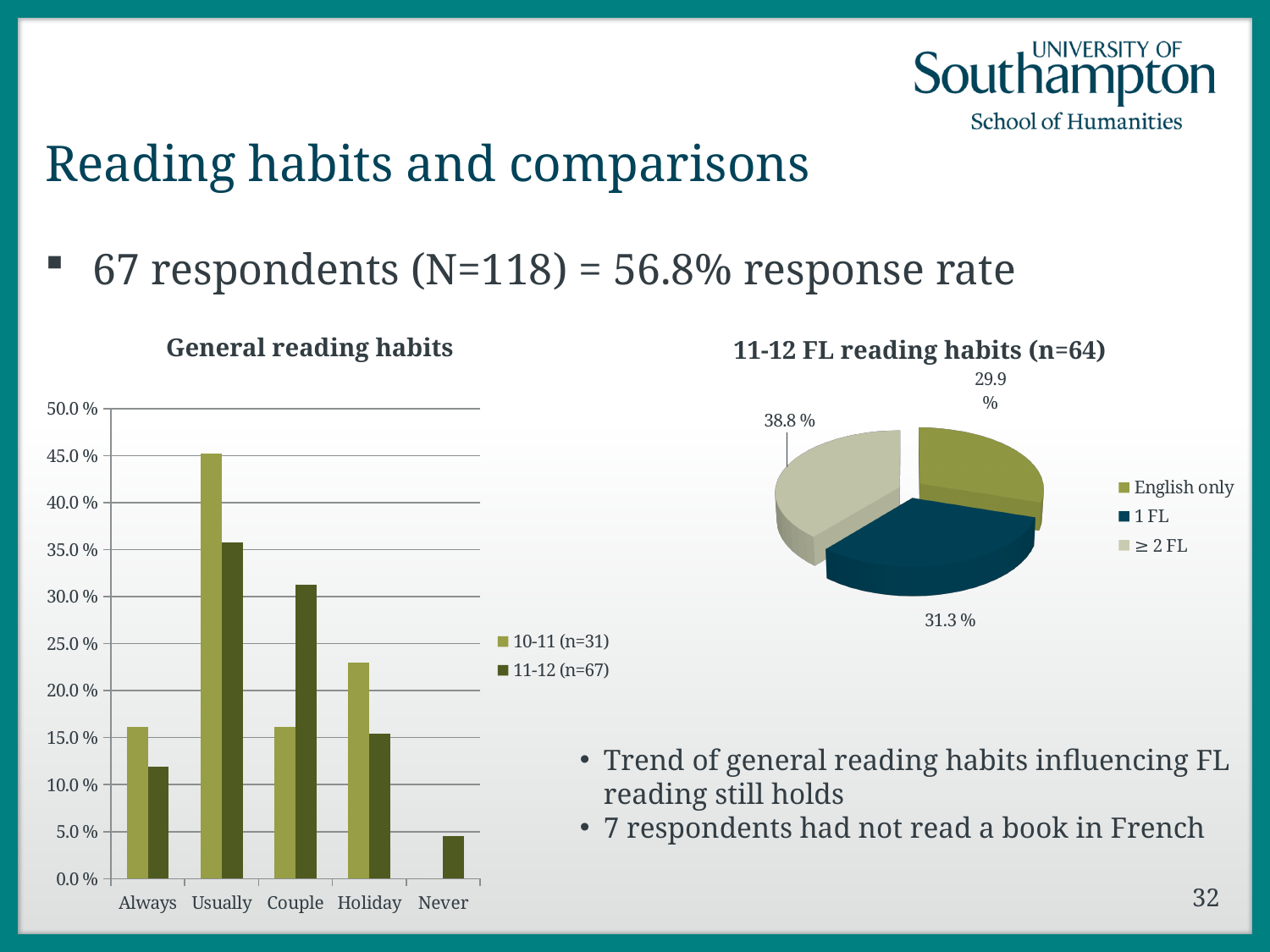
What kind of chart is the '11-12 FL reading habits (n=64)' chart? pie chart In the '11-12 FL reading habits (n=64)' chart, what share is labelled for the 'English only' slice? 29.9 % How many series does the legend of the 'General reading habits' chart list? 2 What kind of chart is the 'General reading habits' chart? bar chart In the '11-12 FL reading habits (n=64)' chart, what share is labelled for the '1 FL' slice? 31.3 % In the 'General reading habits' chart, for the 'Couple' category, which series has the larger value? 11-12 (n=67) In the 'General reading habits' chart, is the value for 'Usually' in the '10-11 (n=31)' series greater or less than 40.0 %? greater In the '11-12 FL reading habits (n=64)' chart, what share is labelled for the '≥ 2 FL' slice? 38.8 % In the 'General reading habits' chart, which category has the highest value for the '10-11 (n=31)' series? Usually In the '11-12 FL reading habits (n=64)' chart, what is the difference between the '≥ 2 FL' share and the 'English only' share? 8.9 % In the '11-12 FL reading habits (n=64)' chart, which slice is the largest? ≥ 2 FL How many categories are shown on the x axis of the 'General reading habits' chart? 5